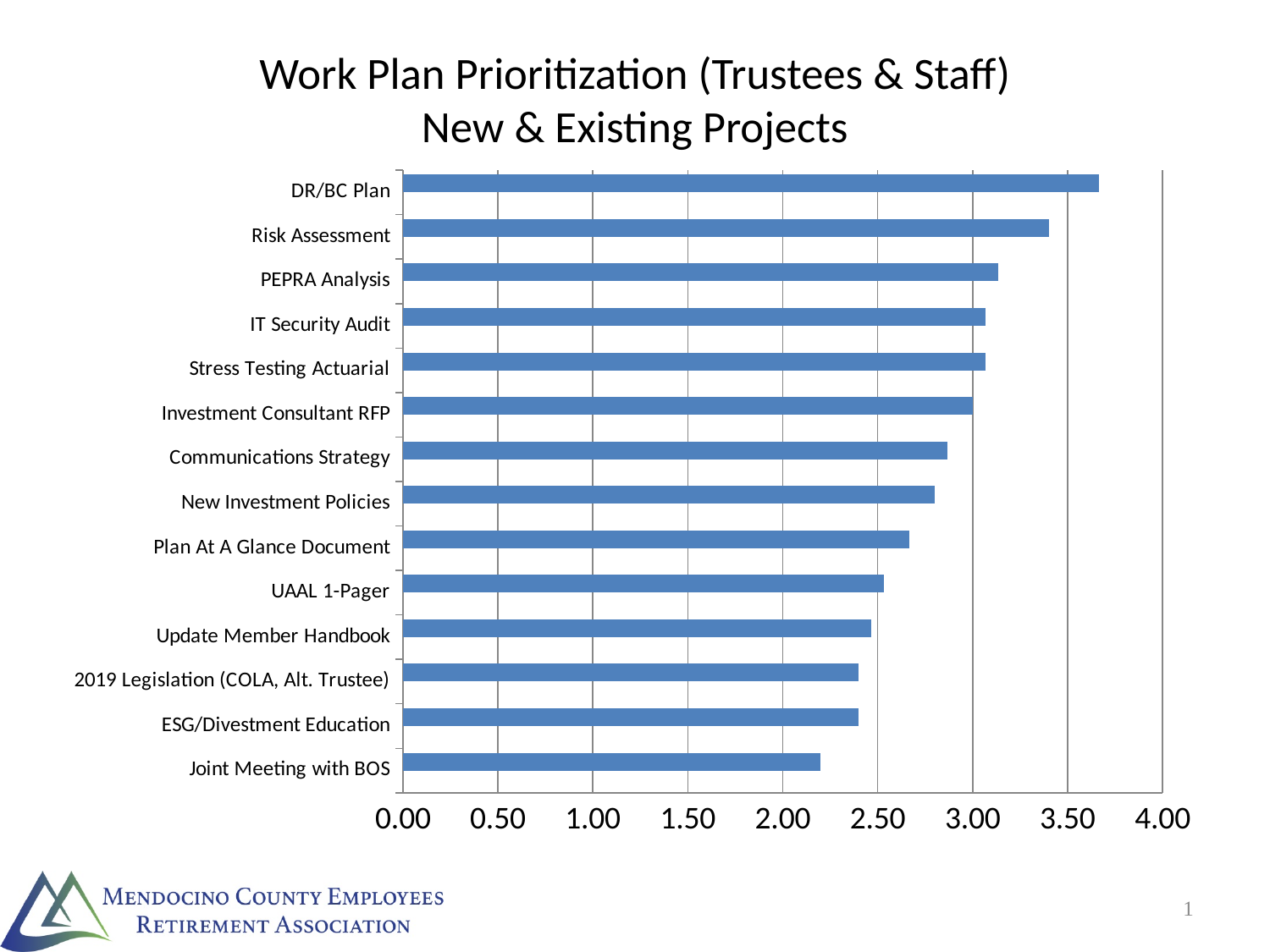
Which has a higher value, Plan At A Glance Document or Update Member Handbook? Plan At A Glance Document Is the value for Joint Meeting with BOS greater or less than 2.50? less Which project has the lowest prioritization score? Joint Meeting with BOS Is the value for Communications Strategy greater or less than 2.50? greater How many projects are listed on the chart? 14 What kind of chart is shown on the slide? bar chart Is the value for Risk Assessment greater or less than 3.00? greater Which has a higher value, Risk Assessment or PEPRA Analysis? Risk Assessment What is the title of the chart? Work Plan Prioritization (Trustees & Staff) New & Existing Projects Which project has the highest prioritization score? DR/BC Plan